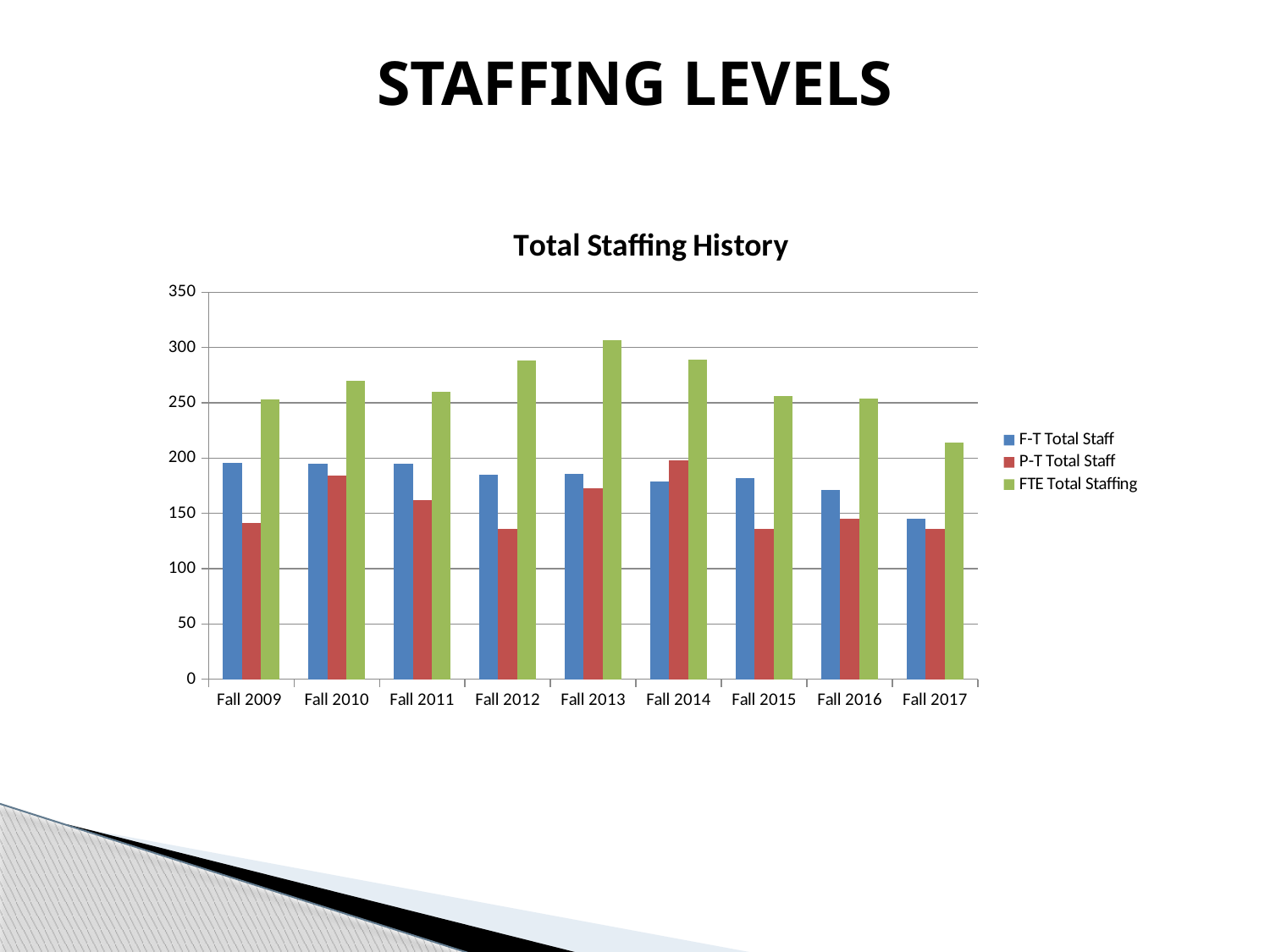
Is the value for FTE Total Staffing in Fall 2013 greater or less than 300? greater Is the value for F-T Total Staff in Fall 2017 greater or less than 150? less How many series does the legend list? 3 In which Fall term is FTE Total Staffing lowest? Fall 2017 Does F-T Total Staff generally rise or fall from Fall 2009 to Fall 2017? Fall How many Fall terms are shown on the x axis? 9 What is the title of the chart? Total Staffing History In Fall 2014, which is larger: F-T Total Staff or P-T Total Staff? P-T Total Staff In which Fall term is FTE Total Staffing highest? Fall 2013 What kind of chart is shown on the slide? Bar chart In which Fall term is F-T Total Staff lowest? Fall 2017 In which Fall term is P-T Total Staff highest? Fall 2014